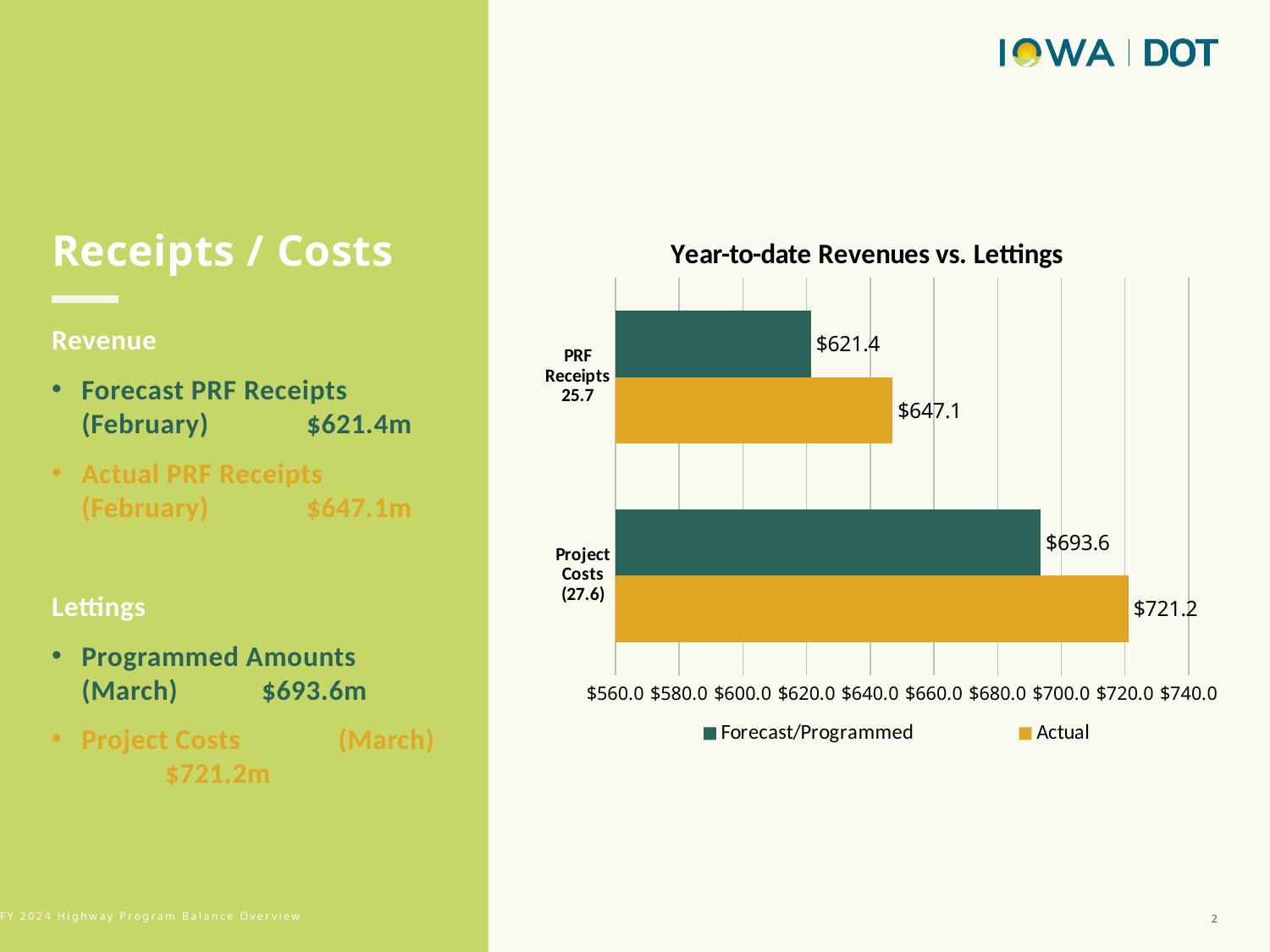
Which category has the highest Actual value? Project Costs Which category has the lowest Forecast/Programmed value? PRF Receipts What is the Actual value for Project Costs? $721.2 What kind of chart is shown on the slide? Bar chart What is the Actual value for PRF Receipts? $647.1 What is the difference between the Actual and Forecast/Programmed values for Project Costs? $27.6 What is the Forecast/Programmed value for PRF Receipts? $621.4 How many series does the legend list? 2 Which is larger for Project Costs, the Forecast/Programmed value or the Actual value? Actual What is the difference between the Actual and Forecast/Programmed values for PRF Receipts? $25.7 How many categories are shown on the chart? 2 What is the Forecast/Programmed value for Project Costs? $693.6